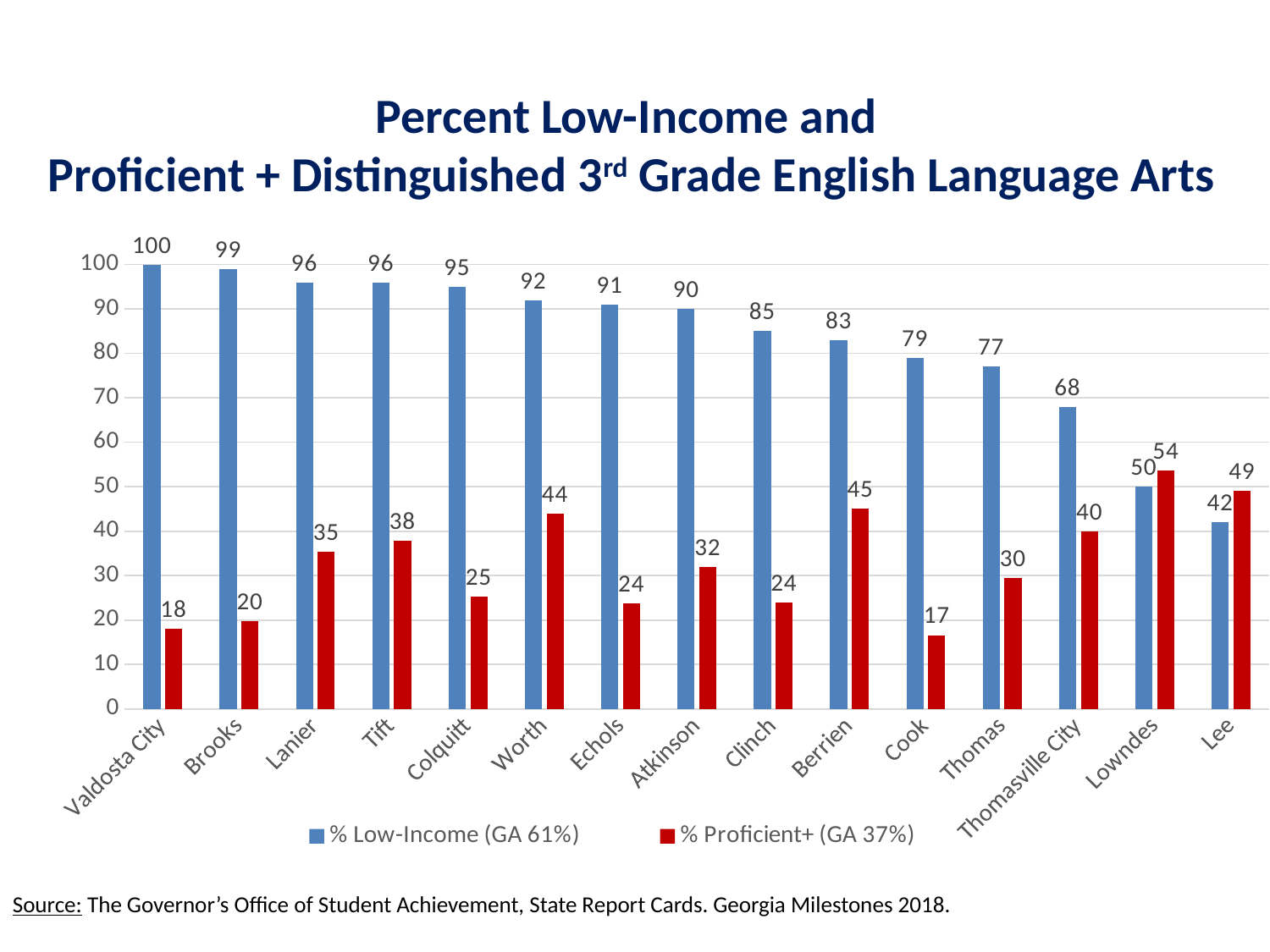
How many counties or districts are shown on the x axis? 15 Do the % Low-Income values rise or fall moving left to right along the x axis? Fall What is the difference between the % Low-Income and % Proficient+ values for Brooks? 79 What kind of chart is shown on the slide? Bar chart What is the % Proficient+ value for Cook? 17 What is the % Proficient+ value for Worth? 44 What Georgia statewide value is given in the legend for % Proficient+? 37% Which is larger for Lowndes, % Low-Income or % Proficient+? % Proficient+ Which county has the lowest % Low-Income value? Lee Which county has the highest % Proficient+ value? Lowndes How many series does the legend list? 2 What is the % Low-Income value for Valdosta City? 100